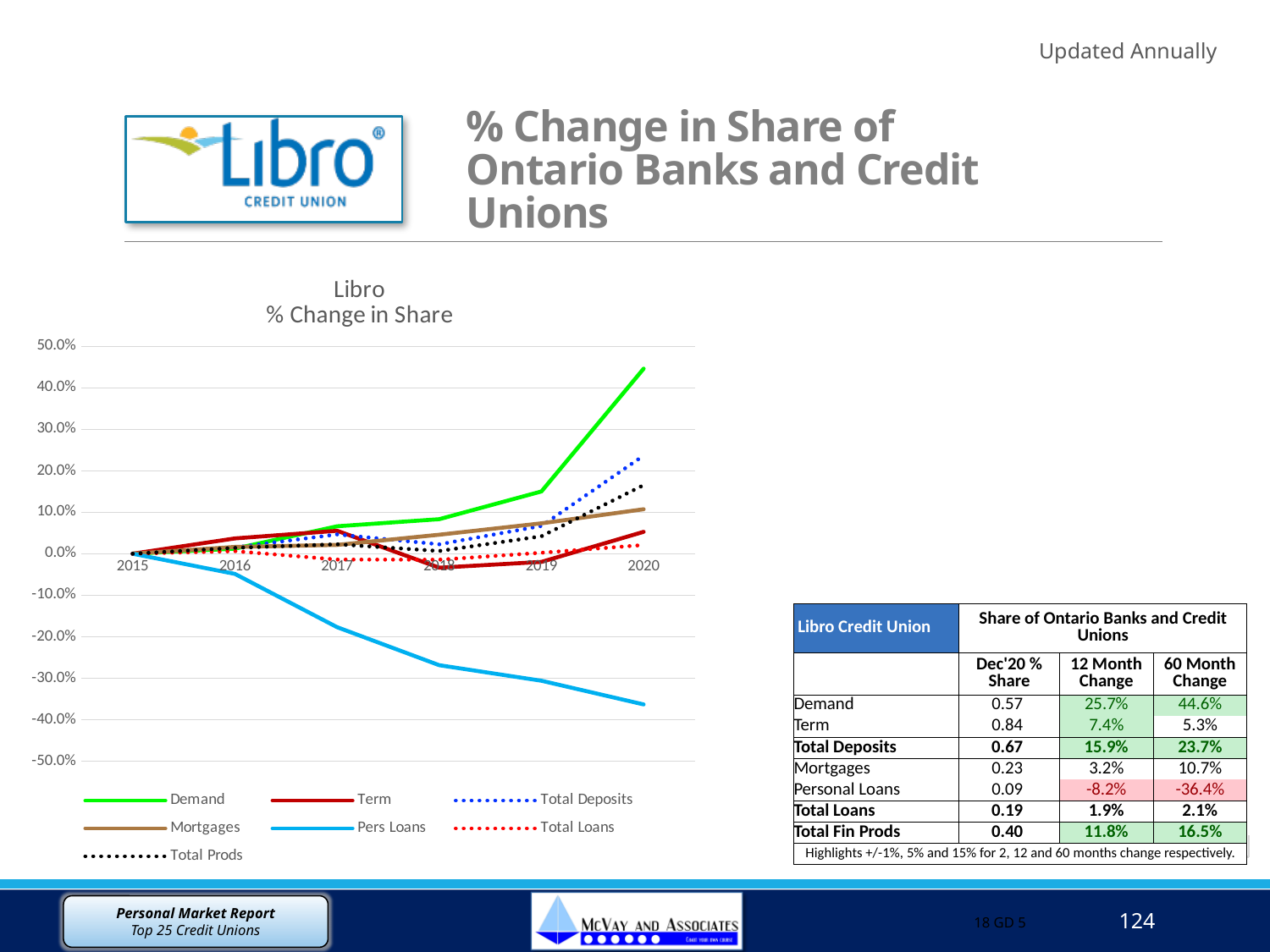
Which series has the lowest value in 2020? Pers Loans Does the Demand line rise or fall from 2015 to 2020? rise Is the value for Demand in 2020 greater or less than 40.0%? greater In 2020, which is larger: Total Deposits or Total Prods? Total Deposits How many years are shown along the x axis of the chart? 6 Is the value for Pers Loans in 2018 greater or less than -20.0%? less What is the title of the chart? Libro % Change in Share What kind of chart is shown on the slide? line chart Does the Pers Loans line rise or fall from 2015 to 2020? fall Is the value for Pers Loans in 2020 greater or less than -30.0%? less Which series has the highest value in 2020? Demand How many series does the chart legend list? 7